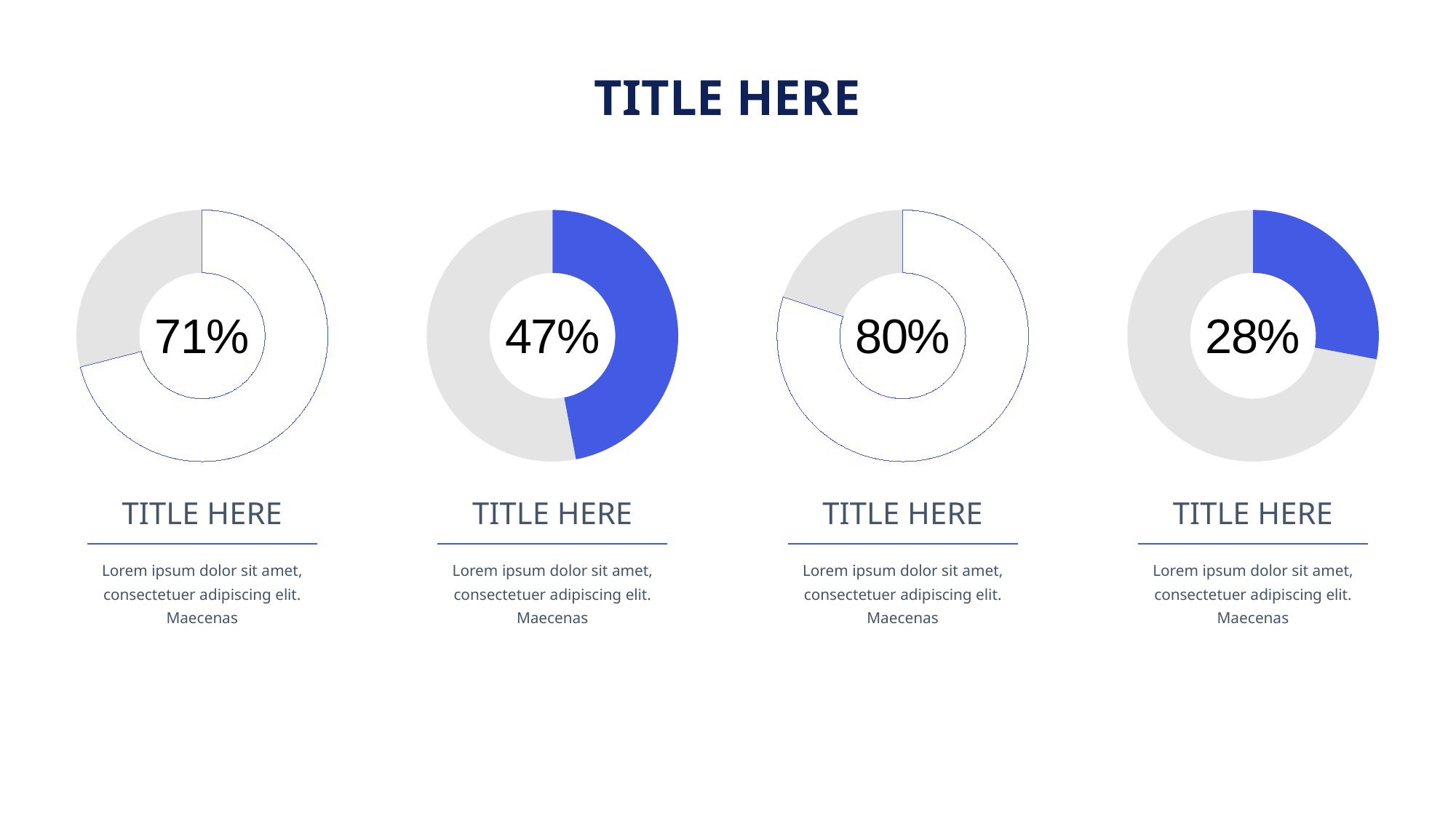
What percentage is shown in the centre of the leftmost donut chart? 71% Which of the four donut charts shows the highest percentage? The third from the left (80%) What percentage is shown in the centre of the second donut chart from the left? 47% What is the main title at the top of the slide? TITLE HERE What is the difference between the percentage in the leftmost donut chart (71%) and the percentage in the second donut chart (47%)? 24% What percentage is shown in the centre of the rightmost donut chart? 28% What percentage is shown in the centre of the third donut chart from the left? 80% Which is larger, the percentage in the leftmost donut chart or the percentage in the second donut chart from the left? The leftmost (71%) How many donut charts are shown on the slide? 4 What is the difference between the percentage in the third donut chart (80%) and the percentage in the rightmost donut chart (28%)? 52% What kind of chart is used to display the percentages on this slide? Donut chart Which of the four donut charts shows the lowest percentage? The rightmost (28%)